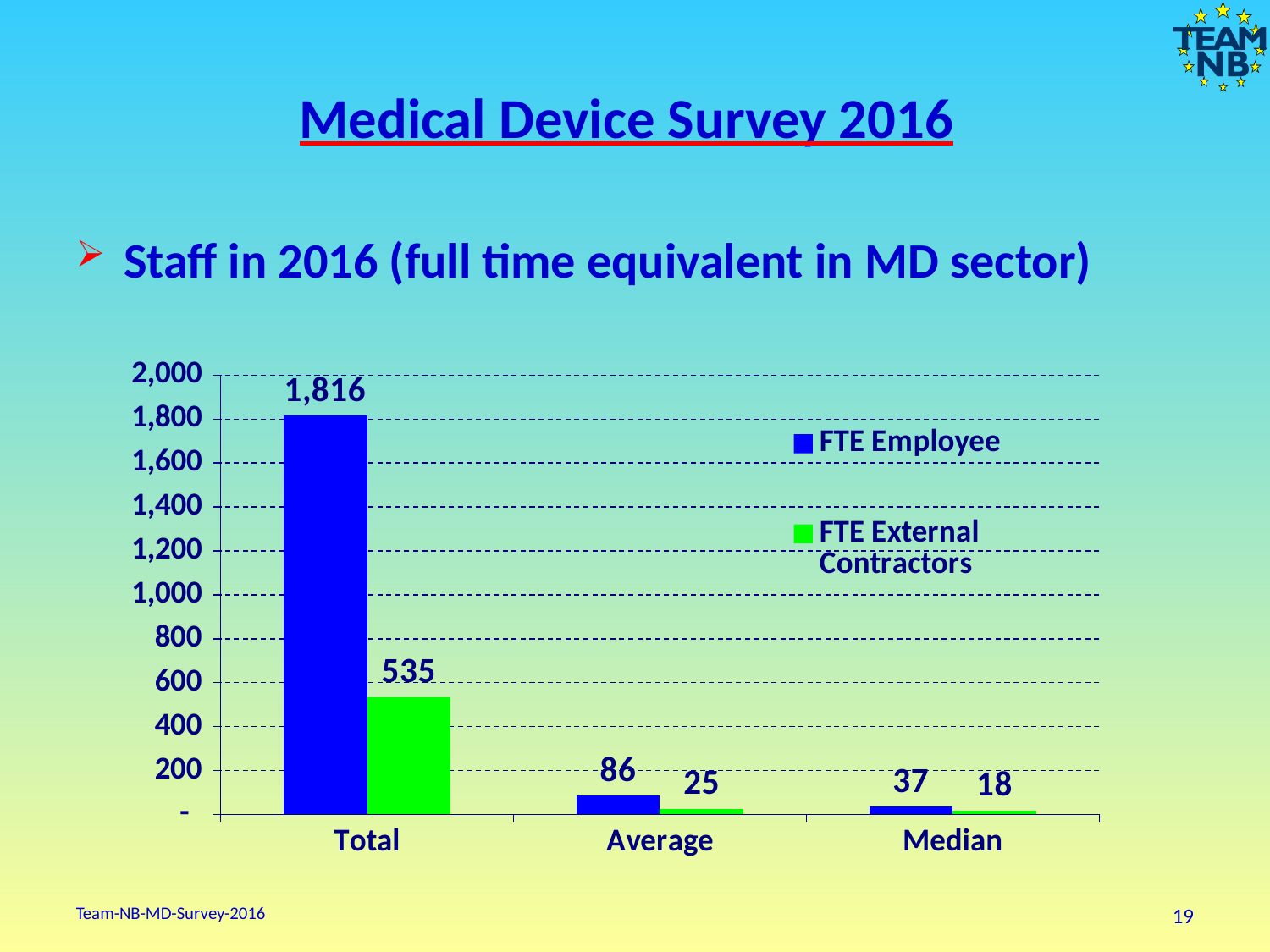
What is the difference between the FTE Employee and FTE External Contractors values for Total? 1,281 What is the FTE External Contractors value for Median? 18 What kind of chart is shown on the slide? Bar chart Which category has the lowest FTE External Contractors value? Median How many categories are shown on the x axis? 3 What is the FTE External Contractors value for Total? 535 What is the FTE Employee value for Average? 86 How many series does the legend list? 2 Which is larger for Average: FTE Employee or FTE External Contractors? FTE Employee Which category has the highest FTE Employee value? Total What is the FTE Employee value for Total? 1,816 What is the difference between the FTE Employee values for Average and Median? 49